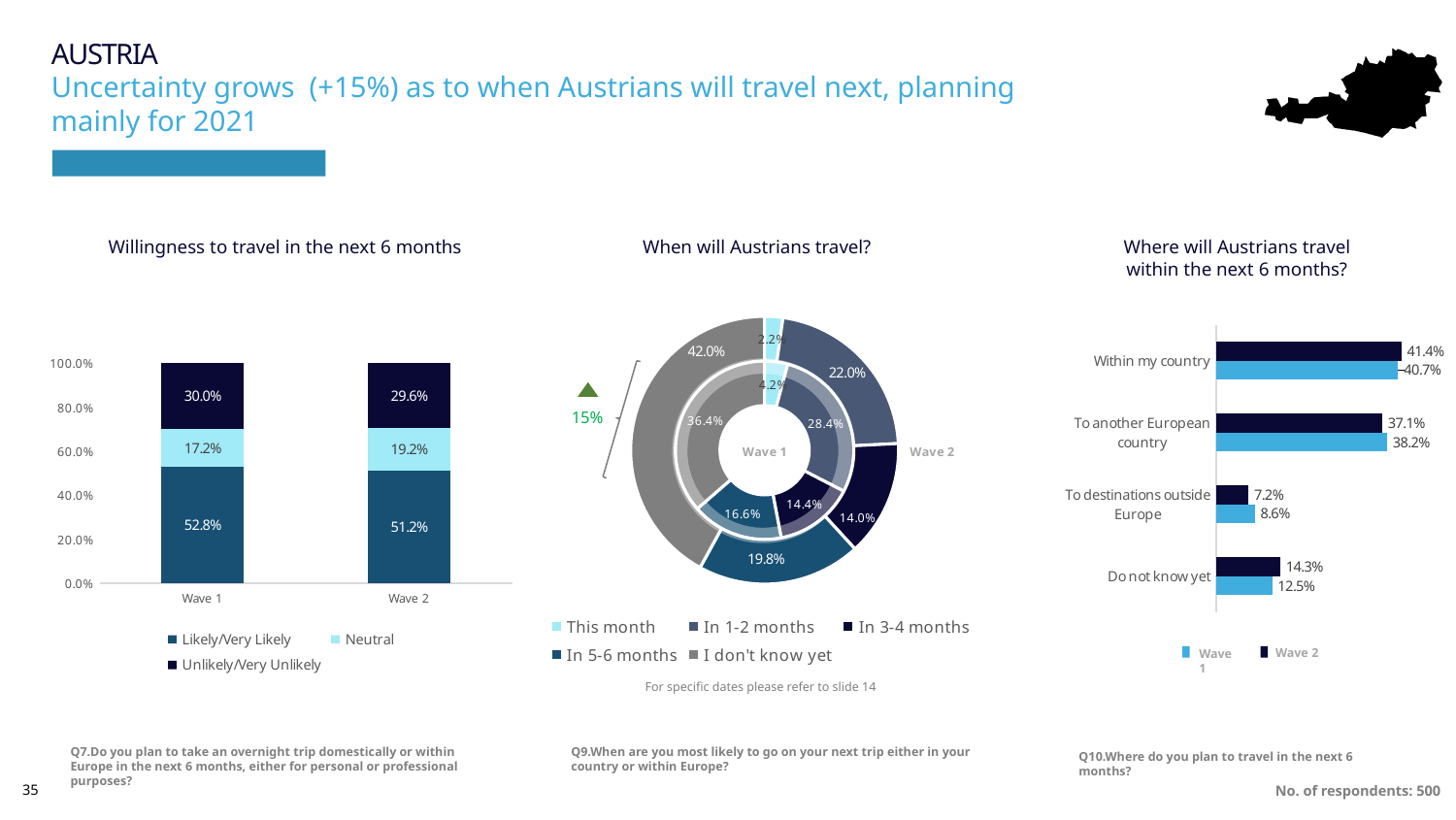
In the 'Willingness to travel in the next 6 months' chart, what is the Likely/Very Likely value for Wave 1? 52.8% In the 'Where will Austrians travel within the next 6 months?' chart, which is larger for 'Do not know yet': Wave 1 or Wave 2? Wave 2 In the 'When will Austrians travel?' chart, what is the Wave 2 share for 'I don't know yet'? 42.0% How many categories does the legend of the 'When will Austrians travel?' chart list? 5 What kind of chart is 'Willingness to travel in the next 6 months'? Stacked bar chart In the 'When will Austrians travel?' chart, what is the Wave 1 share for 'In 1-2 months'? 28.4% In the 'Where will Austrians travel within the next 6 months?' chart, which category has the highest Wave 2 value? Within my country In the 'Where will Austrians travel within the next 6 months?' chart, what is the Wave 1 value for 'To another European country'? 38.2% How many series does the legend of the 'Willingness to travel in the next 6 months' chart list? 3 In the 'Willingness to travel in the next 6 months' chart, what is the Neutral value for Wave 2? 19.2% In the 'When will Austrians travel?' chart, which category has the smallest share in Wave 2? This month In the 'Willingness to travel in the next 6 months' chart, what is the difference between the Unlikely/Very Unlikely values for Wave 1 and Wave 2? 0.4%